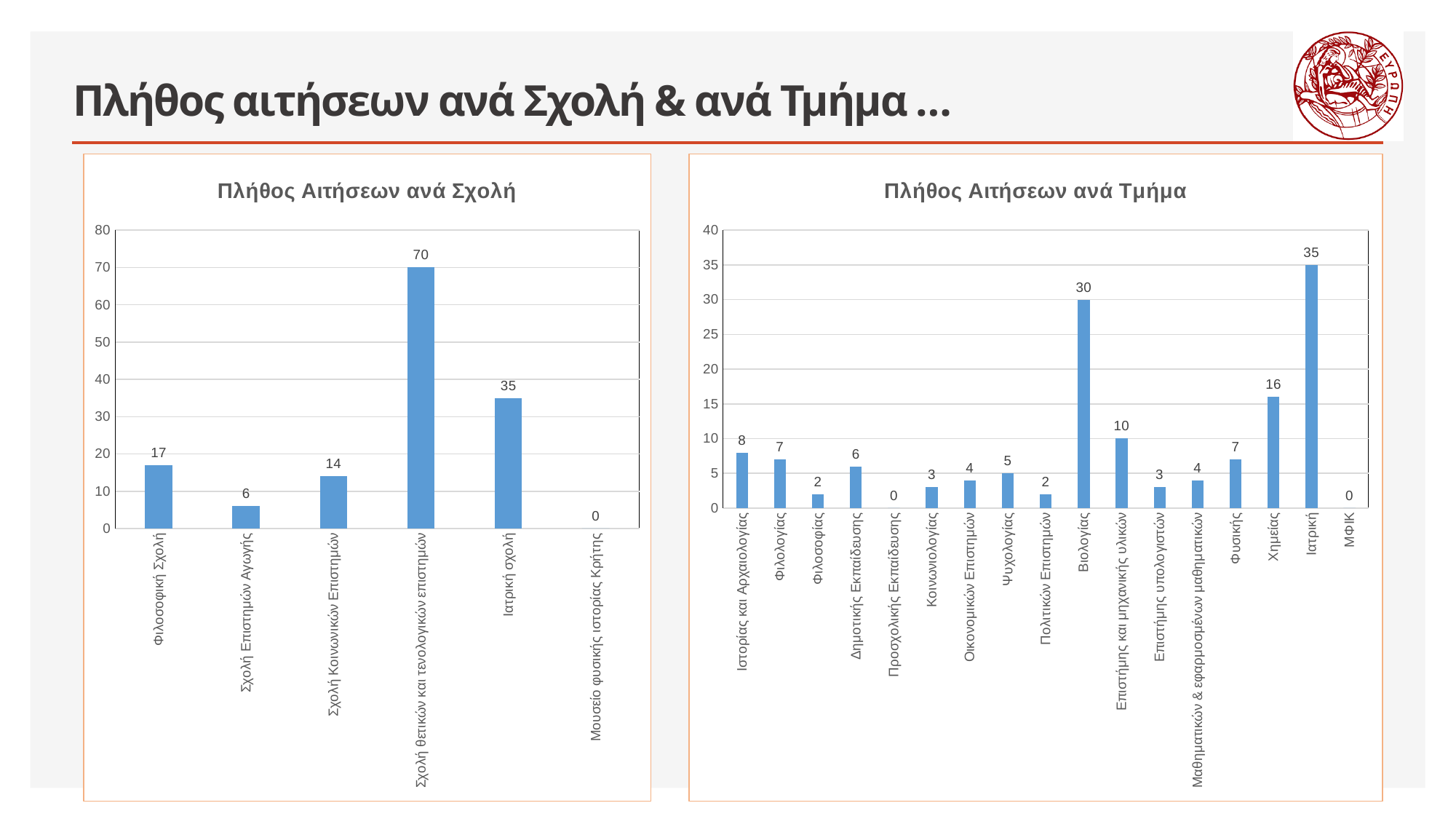
In the chart 'Πλήθος Αιτήσεων ανά Σχολή', which category has the highest value? Σχολή θετικών και τενολογικών επιστημών In the chart 'Πλήθος Αιτήσεων ανά Τμήμα', which category has the highest value? Ιατρική In the chart 'Πλήθος Αιτήσεων ανά Σχολή', what is the value for Φιλοσοφική Σχολή? 17 In the chart 'Πλήθος Αιτήσεων ανά Τμήμα', what is the value for Βιολογίας? 30 In the chart 'Πλήθος Αιτήσεων ανά Τμήμα', how many categories are shown? 17 What type of chart is 'Πλήθος Αιτήσεων ανά Σχολή'? Bar chart In the chart 'Πλήθος Αιτήσεων ανά Τμήμα', which is larger: Ιστορίας και Αρχαιολογίας or Φυσικής? Ιστορίας και Αρχαιολογίας In the chart 'Πλήθος Αιτήσεων ανά Σχολή', how many categories are shown? 6 In the chart 'Πλήθος Αιτήσεων ανά Σχολή', what is the difference between Σχολή θετικών και τεχνολογικών επιστημών and Ιατρική σχολή? 35 In the chart 'Πλήθος Αιτήσεων ανά Τμήμα', what is the value for Χημείας? 16 In the chart 'Πλήθος Αιτήσεων ανά Τμήμα', what is the difference between Ιατρική and Επιστήμης και μηχανικής υλικών? 25 In the chart 'Πλήθος Αιτήσεων ανά Σχολή', which category has the lowest value? Μουσείο φυσικής ιστορίας Κρήτης